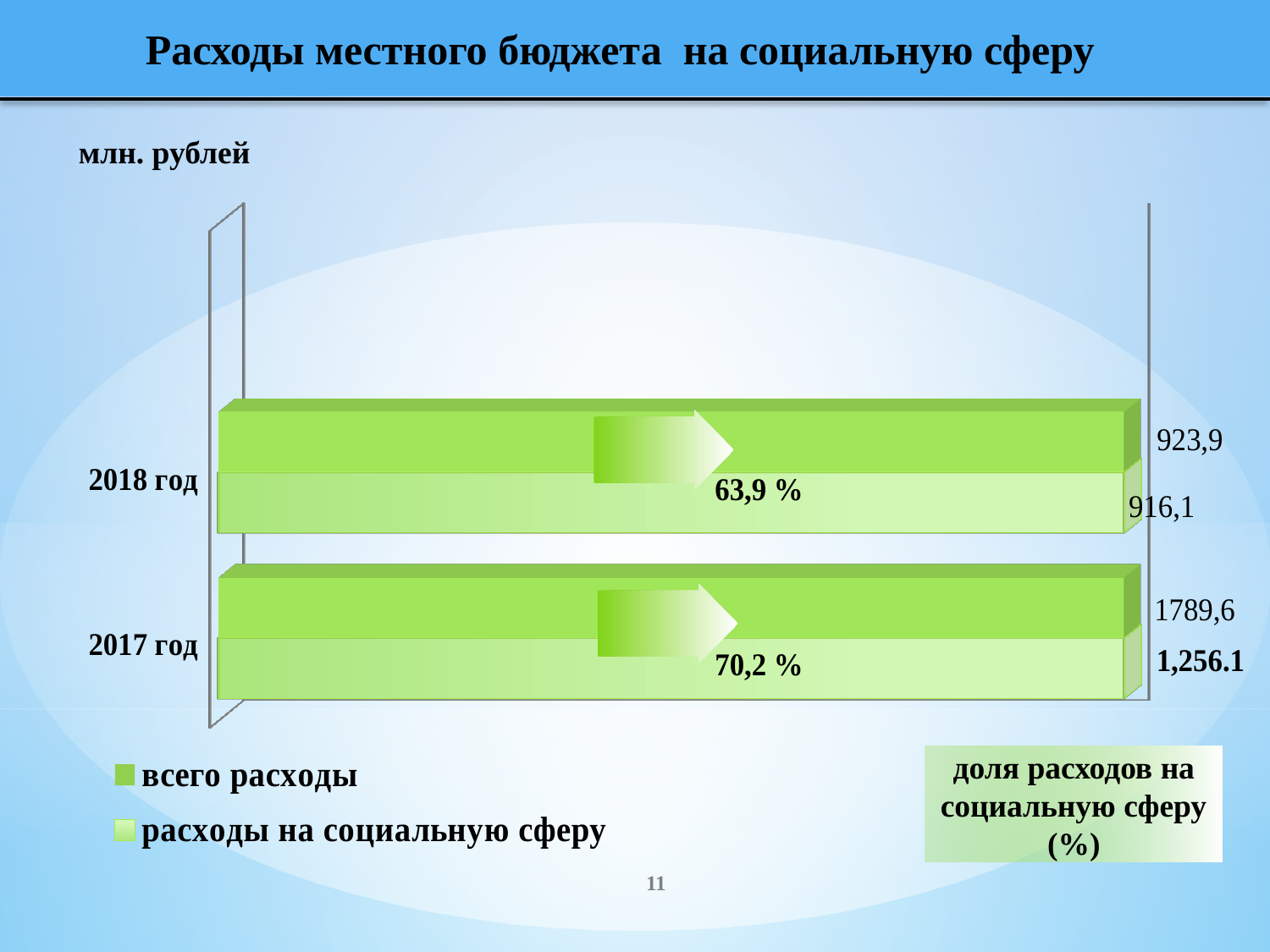
What is the difference between всего расходы and расходы на социальную сферу in 2018 год? 7,8 What is the value of всего расходы for 2017 год? 1789,6 What is the value of всего расходы for 2018 год? 923,9 What share of expenditure went to the social sphere (доля расходов на социальную сферу) in 2017 год? 70,2 % What is the value of расходы на социальную сферу for 2018 год? 916,1 Which year has the lower share of expenditure on the social sphere? 2018 год What kind of chart is shown on the slide? bar chart What share of expenditure went to the social sphere (доля расходов на социальную сферу) in 2018 год? 63,9 % How many series does the legend list? 2 Which year has the higher value of всего расходы? 2017 год What is the difference between всего расходы in 2017 год and in 2018 год? 865,7 What is the value of расходы на социальную сферу for 2017 год? 1,256.1